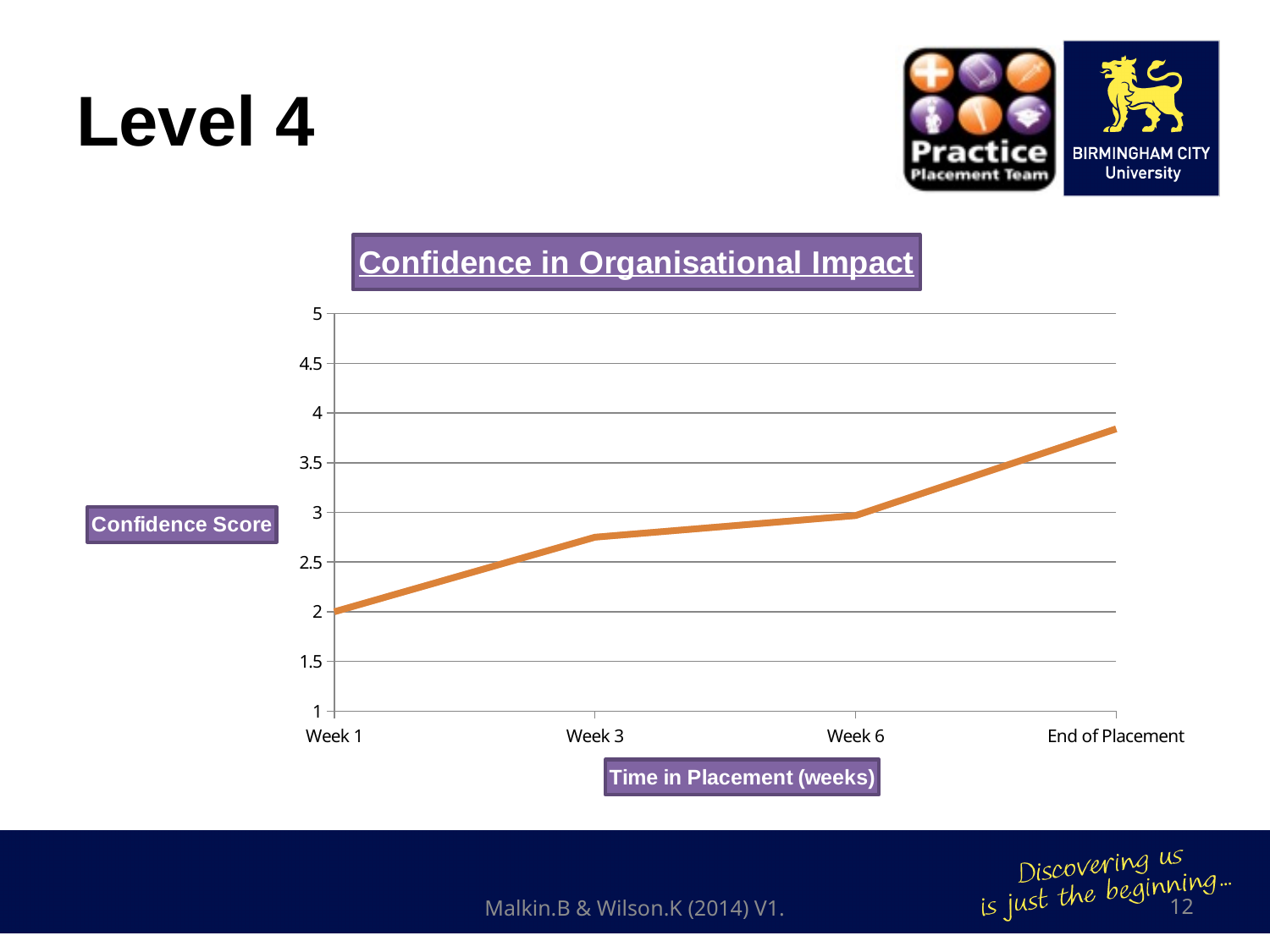
What is the confidence score at Week 1? 2 What is the label on the x axis of the chart? Time in Placement (weeks) Is the confidence score at End of Placement greater or less than 3.5? greater What kind of chart is shown on the slide? line chart At which time point is the confidence score highest? End of Placement At which time point is the confidence score lowest? Week 1 Which has a higher confidence score, Week 1 or Week 3? Week 3 Does the confidence score rise or fall from Week 1 to End of Placement? rise What is the title of the chart? Confidence in Organisational Impact Is the confidence score at End of Placement greater or less than 4? less Is the confidence score at Week 3 greater or less than 2.5? greater How many time points are plotted on the chart? 4